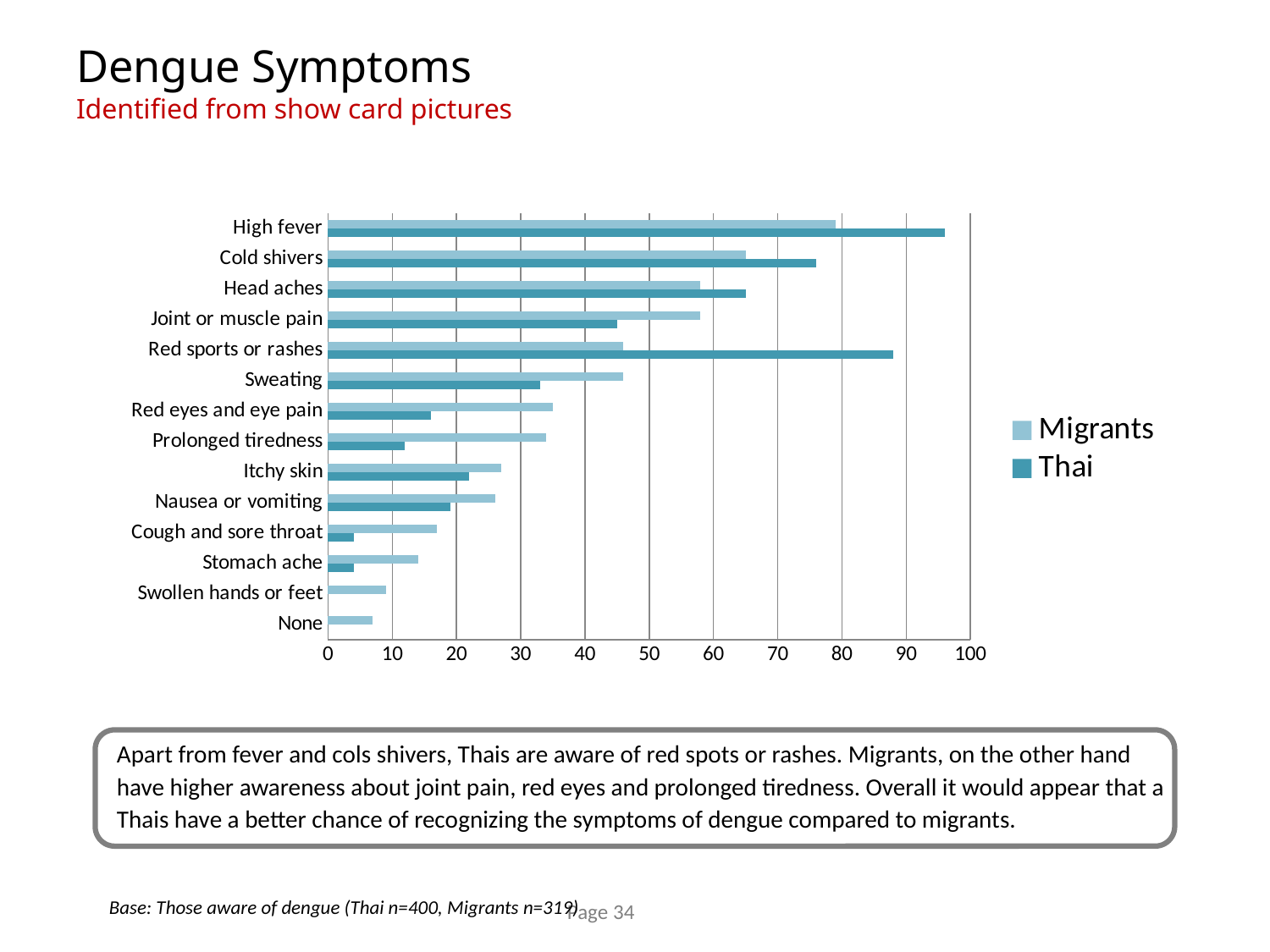
How many series does the legend list? 2 What kind of chart is shown on the slide? bar chart Which category has the lowest value for the Migrants series? None What are the two series named in the legend? Migrants and Thai How many symptom categories are plotted on the chart? 14 For Red sports or rashes, which series has the larger value, Migrants or Thai? Thai Is the Migrants value for Joint or muscle pain greater or less than 50? greater For Prolonged tiredness, which series has the larger value, Migrants or Thai? Migrants Which symptom has the highest value for the Thai series? High fever Is the Thai value for High fever greater or less than 90? greater Is the Thai value for Stomach ache greater or less than 10? less